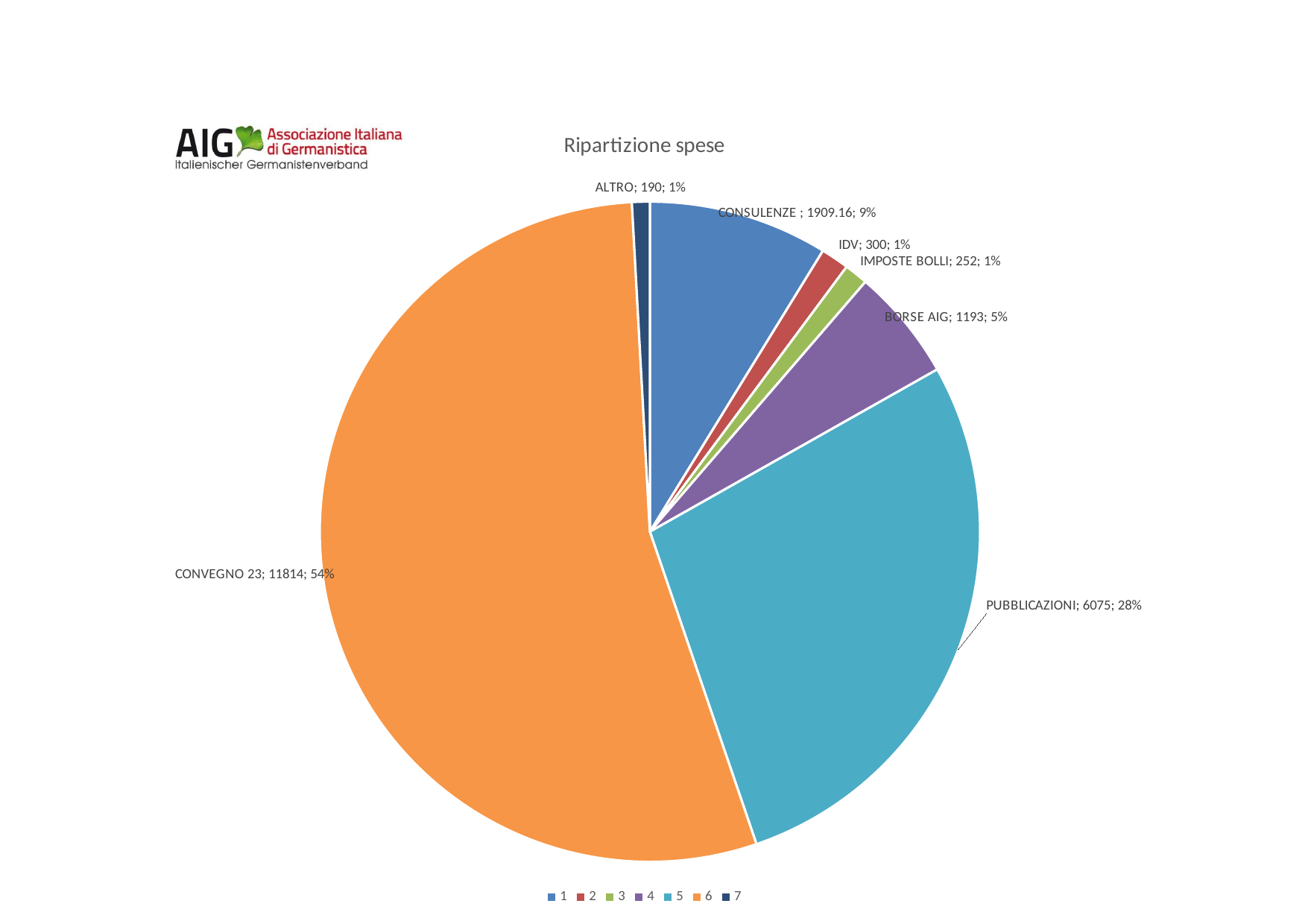
What is the title of the chart? Ripartizione spese How many slices does the pie chart have? 7 What share of the pie does PUBBLICAZIONI represent? 28% What share of the pie does CONVEGNO 23 represent? 54% What is the difference between the values for IDV and IMPOSTE BOLLI? 48 What type of chart is shown on the slide? Pie chart What is the value for PUBBLICAZIONI? 6075 Which is larger, the value for BORSE AIG or the value for CONSULENZE? CONSULENZE Which category has the smallest slice of the pie? ALTRO What is the value for BORSE AIG? 1193 Which category has the largest slice of the pie? CONVEGNO 23 What is the value for CONSULENZE? 1909.16